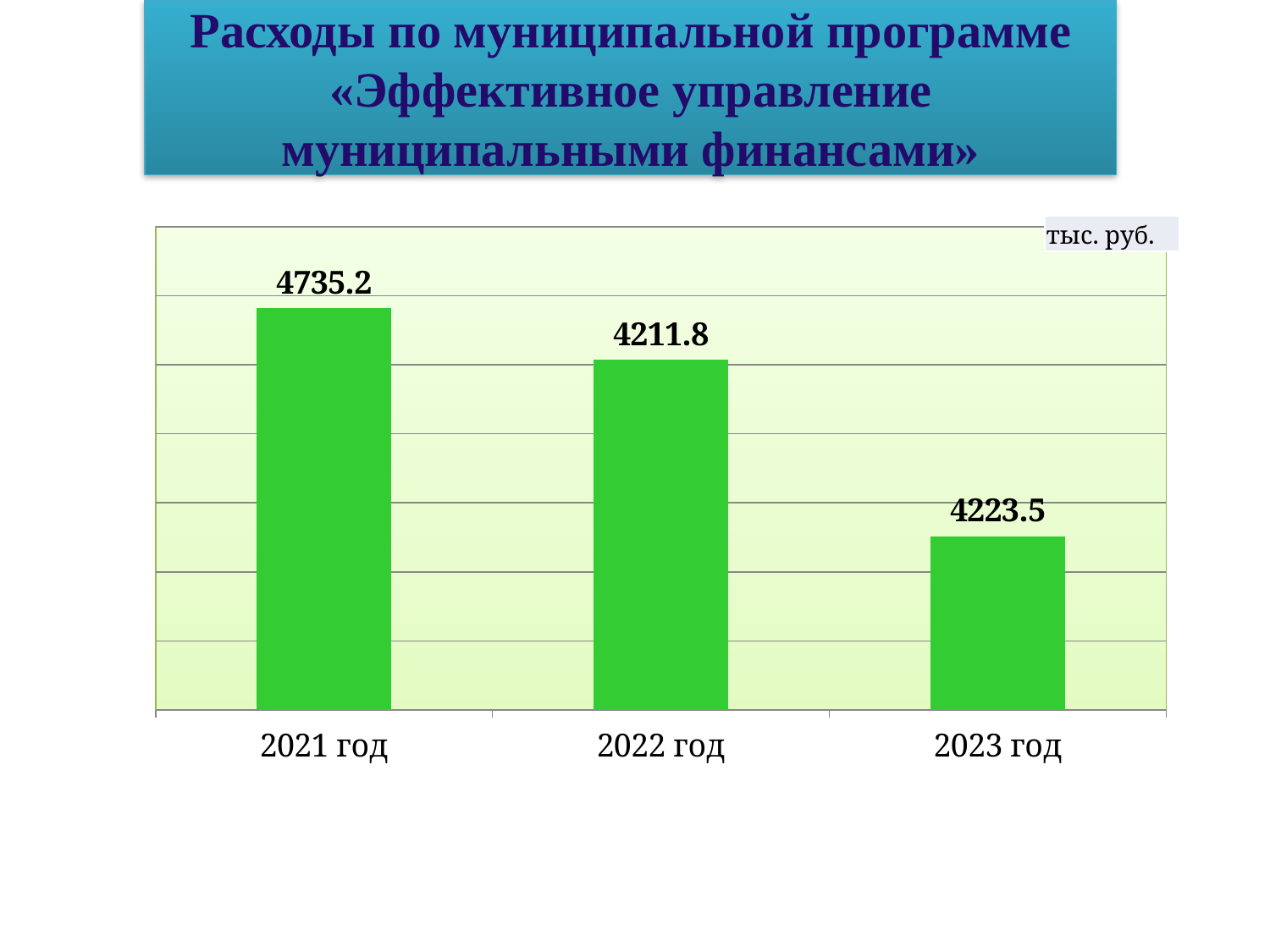
Which year has the highest value? 2021 год What is the difference between the values for 2021 год and 2022 год? 523.4 What kind of chart is shown on the slide? bar chart What is the difference between the values for 2021 год and 2023 год? 511.7 What unit is indicated in the top right corner of the chart? тыс. руб. What colour are the bars in the chart? green What is the value for 2023 год? 4223.5 How many years are shown on the chart? 3 What is the value for 2022 год? 4211.8 What is the value for 2021 год? 4735.2 Which is larger, the value for 2021 год or the value for 2023 год? 2021 год